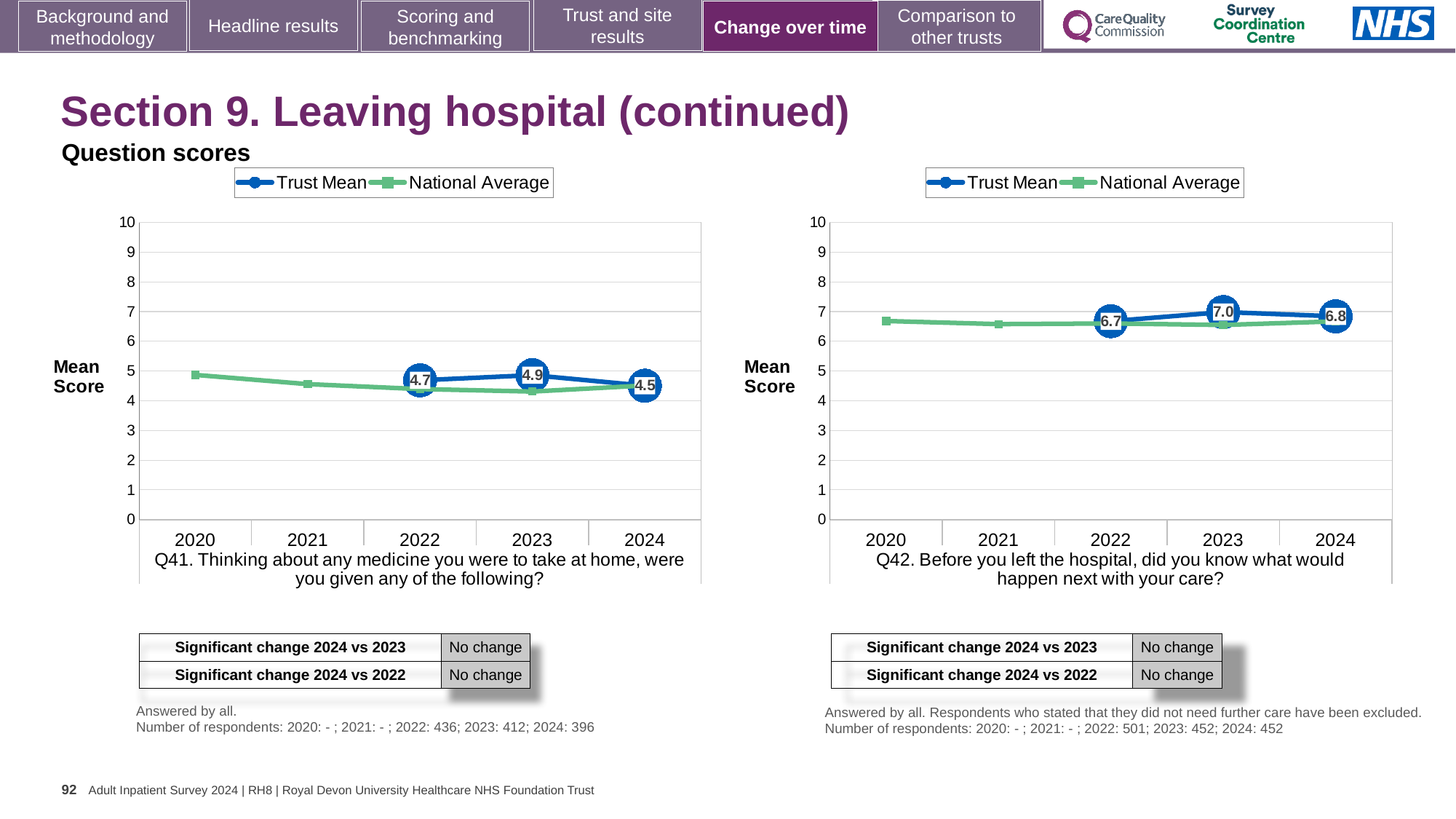
In the Q42 chart on the right, which year has the highest Trust Mean score? 2023 In the Q42 chart on the right, what is the Trust Mean score for 2022? 6.7 In the Q41 chart on the left, what is the Trust Mean score for 2024? 4.5 In the Q41 chart on the left, which year has the lowest labelled Trust Mean score? 2024 In the Q41 chart on the left, is the National Average for 2020 greater or less than 4? greater How many years are shown on the x axis of the Q42 chart on the right? 5 How many series does the legend of the Q41 chart on the left list? 2 In the Q42 chart on the right, is the Trust Mean score for 2023 higher or lower than for 2024? higher In the Q41 chart on the left, what is the difference between the Trust Mean scores for 2023 and 2024? 0.4 In the Q42 chart on the right, what is the difference between the Trust Mean scores for 2023 and 2022? 0.3 In the Q41 chart on the left, what is the Trust Mean score for 2023? 4.9 What type of chart is used for Q42 on the right? Line chart